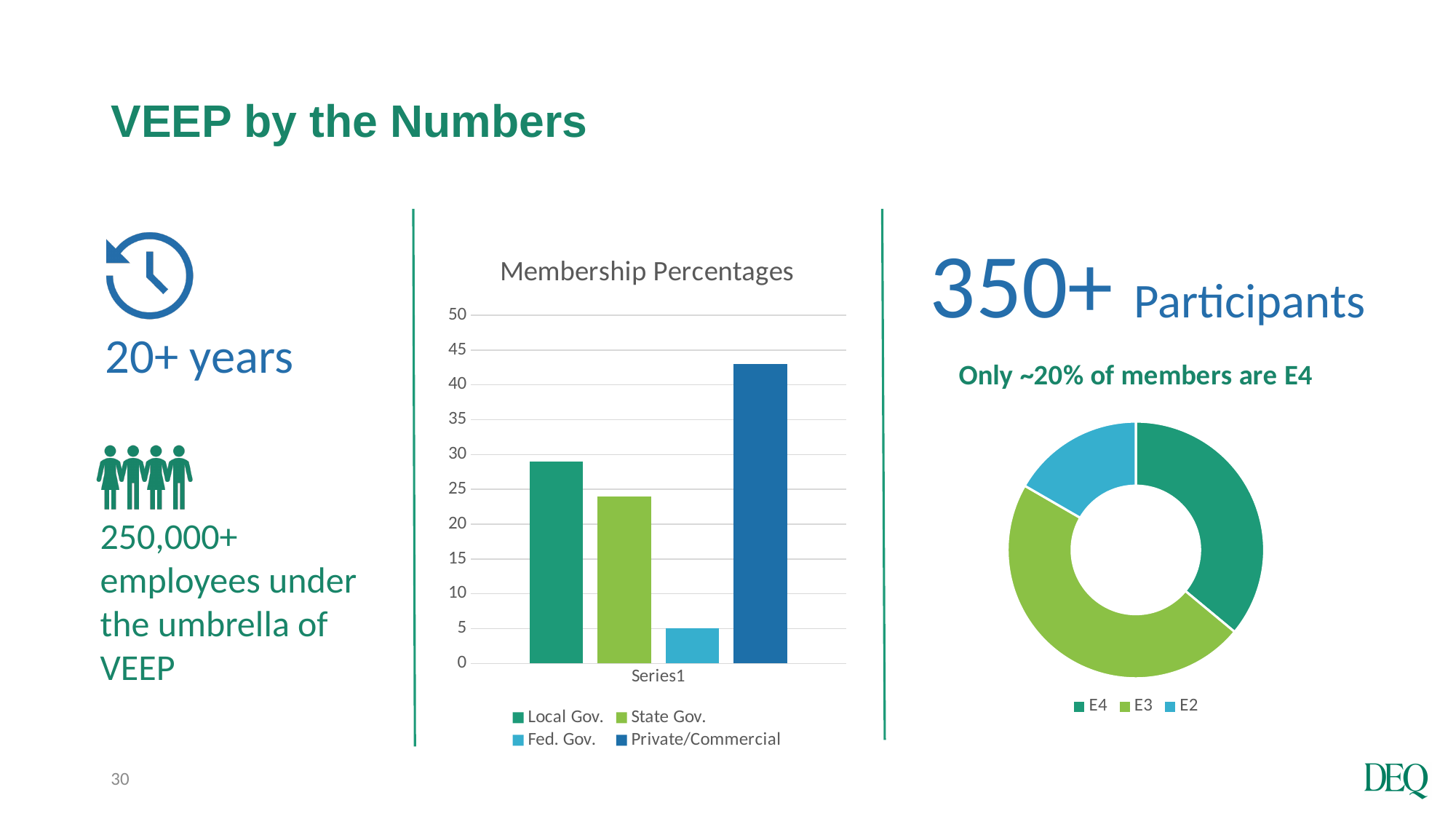
In the doughnut chart on the right, which category has the smallest share? E2 In the Membership Percentages chart, is the value for State Gov. greater or less than 25? less In the Membership Percentages chart, which series has the highest value? Private/Commercial What type of chart is the Membership Percentages chart? bar chart How many series does the legend of the Membership Percentages chart list? 4 What is the title of the bar chart in the middle of the slide? Membership Percentages In the doughnut chart on the right, which category has the largest share? E3 In the Membership Percentages chart, which is larger, Local Gov. or State Gov.? Local Gov. In the Membership Percentages chart, is the value for Private/Commercial greater or less than 40? greater In the Membership Percentages chart, which series has the lowest value? Fed. Gov. What type of chart is the chart on the right of the slide showing E4, E3 and E2? doughnut chart In the Membership Percentages chart, is the value for Local Gov. greater or less than 25? greater